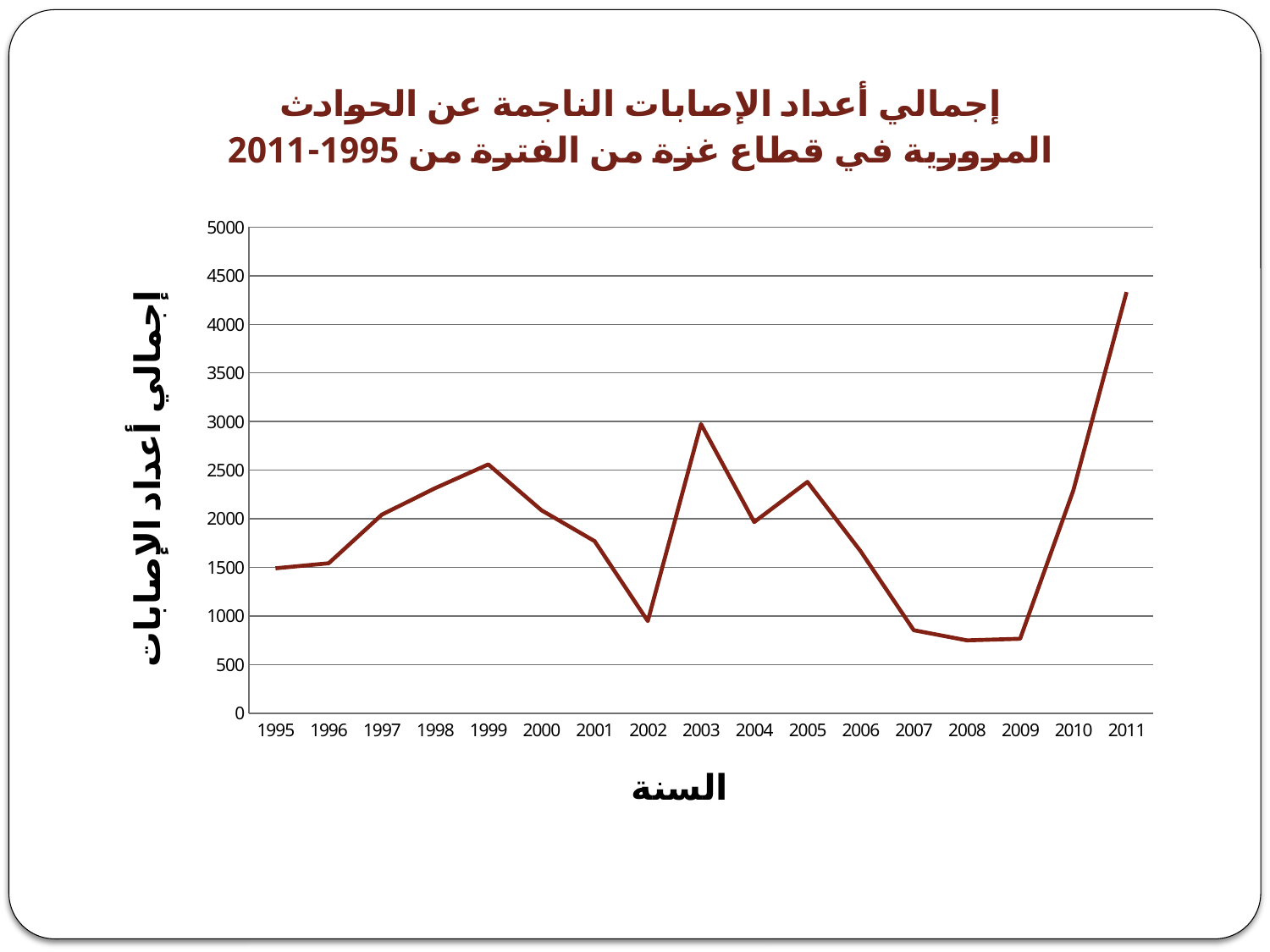
Is the value for 2011 greater or less than 4000? greater Which year has the larger value, 2001 or 2002? 2001 How many years are plotted along the x axis? 17 Is the value for 2010 greater or less than 2000? greater What kind of chart is shown on the slide? line chart What is the label of the x axis? السنة Is the value for 2003 greater or less than 2500? greater Which year has the highest number of injuries? 2011 Which year has the larger value, 2003 or 2005? 2003 Do the values rise or fall from 2009 to 2011? rise